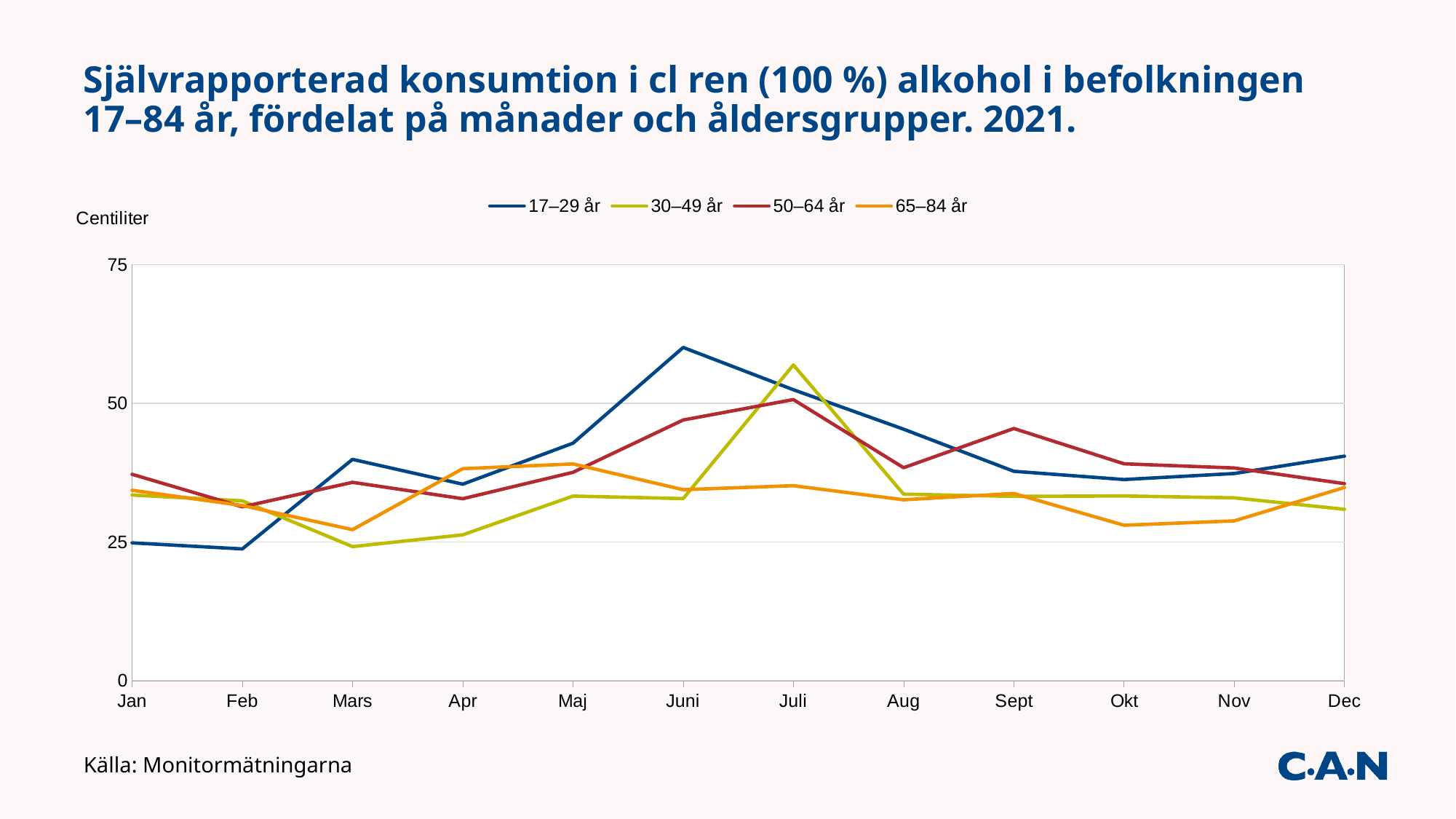
Which age group has the lowest value in Juli? 65–84 år What kind of chart is shown on the slide? line chart Which age group has the highest value in Juni? 17–29 år Which age group has the highest value in Sept? 50–64 år Is the value for 30–49 år in Juli greater or less than 50? greater Does the 17–29 år line rise or fall from Juni to Sept? fall Is the value for 17–29 år in Juni greater or less than 50? greater Is the value for 50–64 år in Juni greater or less than 50? less Which age group has the lowest value in Feb? 17–29 år How many months are plotted along the x axis? 12 What unit is shown on the y axis label? Centiliter How many age groups does the legend list? 4